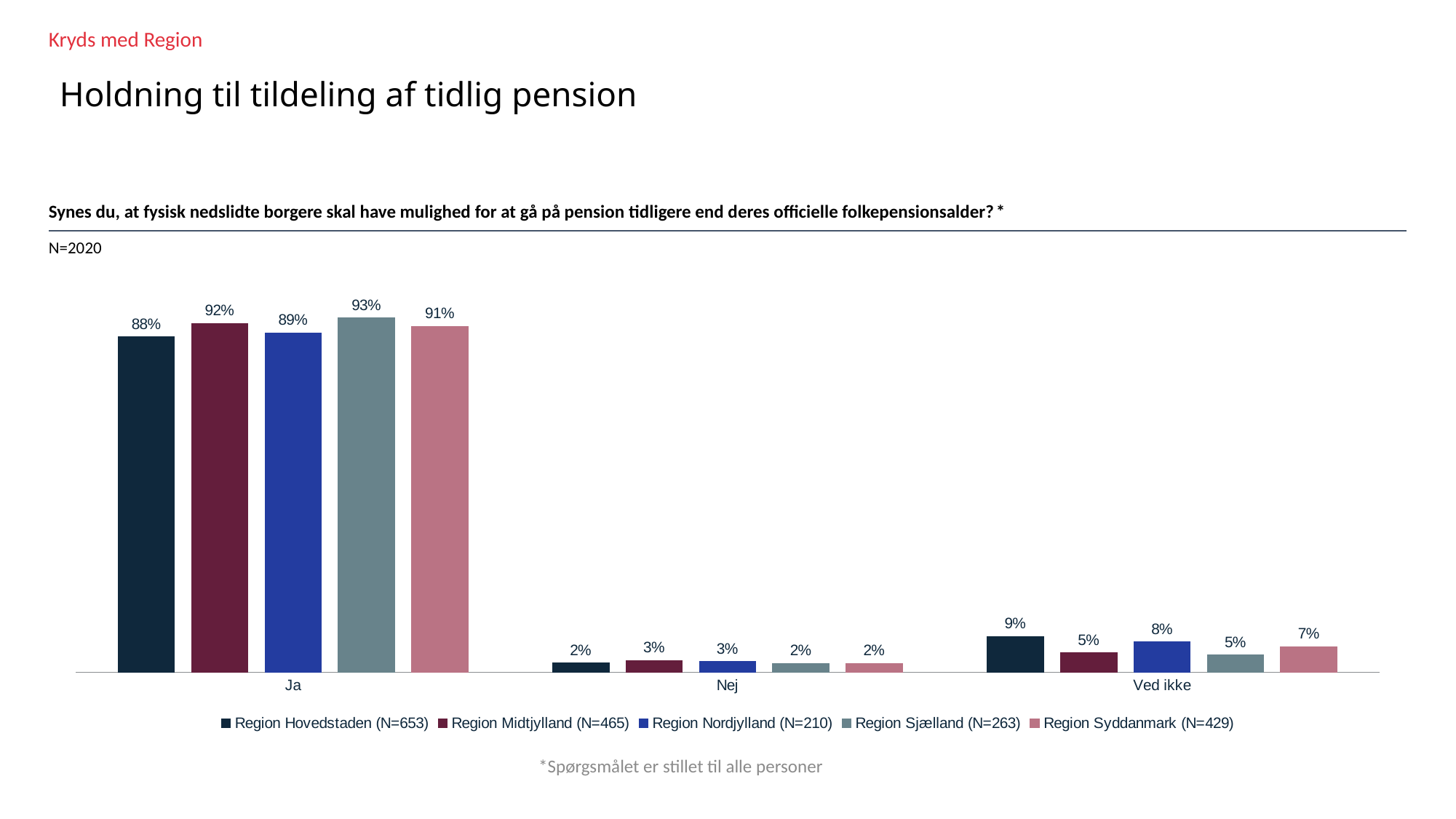
What is the value for Region Nordjylland (N=210) in the Ved ikke category? 8% What is the value for Region Sjælland (N=263) in the Ja category? 93% How many answer categories are shown on the x axis? 3 What kind of chart is shown on the slide? Bar chart Which region has the highest value in the Ja category? Region Sjælland (N=263) How many series does the legend list? 5 What is the value for Region Hovedstaden (N=653) in the Ja category? 88% What is the value for Region Syddanmark (N=429) in the Nej category? 2% What is the difference between Region Sjælland (N=263) and Region Hovedstaden (N=653) in the Ja category? 5% Which region has the lowest value in the Ved ikke category? Region Midtjylland (N=465) and Region Sjælland (N=263) Which is larger in the Ved ikke category: Region Hovedstaden (N=653) or Region Syddanmark (N=429)? Region Hovedstaden (N=653) What is the N value stated above the chart? N=2020